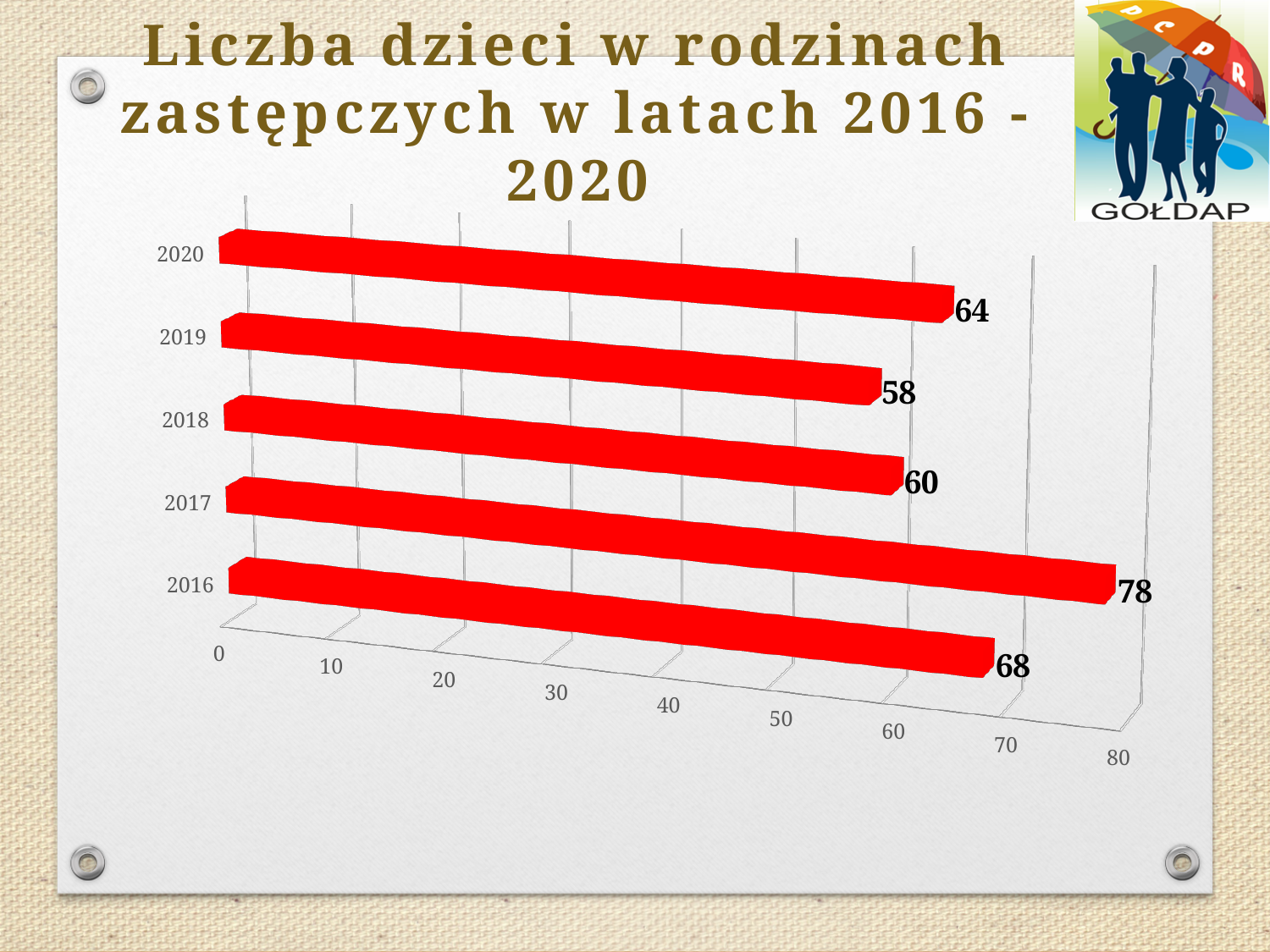
What value is shown for 2019? 58 What is the difference between the values for 2016 and 2020? 4 Which is larger, the value for 2018 or the value for 2020? 2020 What is the number of children in foster families shown for 2016? 68 How many years are shown on the chart? 5 What kind of chart is shown on the slide? bar chart Which year has the highest value? 2017 What is the difference between the values for 2017 and 2019? 20 What value is shown for 2020? 64 What value is shown for 2017? 78 What is the title of the chart on the slide? Liczba dzieci w rodzinach zastępczych w latach 2016 - 2020 Which year has the lowest value? 2019